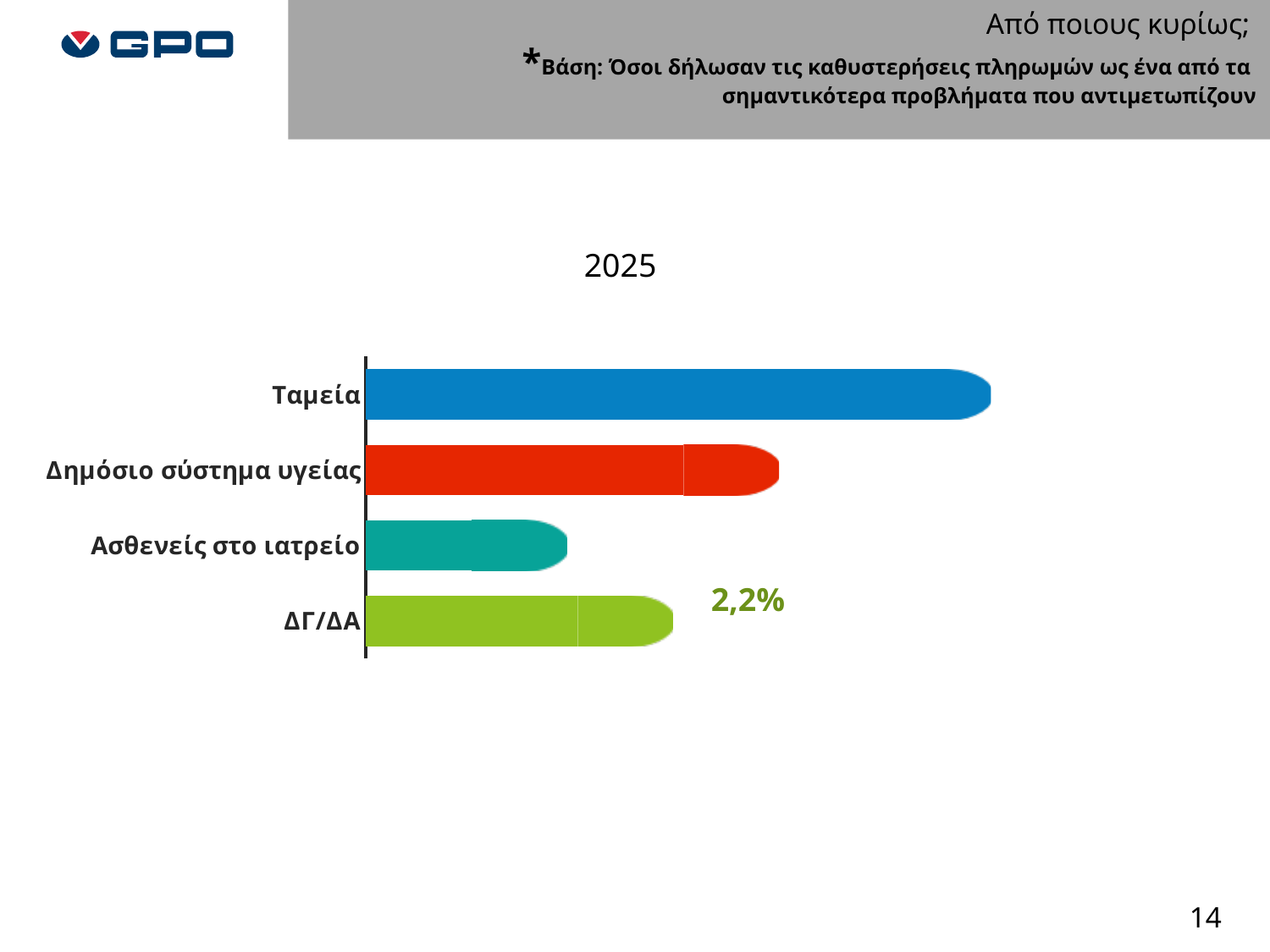
What is the title of the chart? 2025 What type of chart is shown on the slide? bar chart What value is labelled for ΔΓ/ΔΑ? 2,2% Which bar is longer, Ταμεία or Δημόσιο σύστημα υγείας? Ταμεία Which category has the longest bar? Ταμεία Which bar is longer, Δημόσιο σύστημα υγείας or Ασθενείς στο ιατρείο? Δημόσιο σύστημα υγείας What colour is the bar for Ταμεία? blue How many categories are shown in the chart? 4 Which category is listed at the top of the chart? Ταμεία